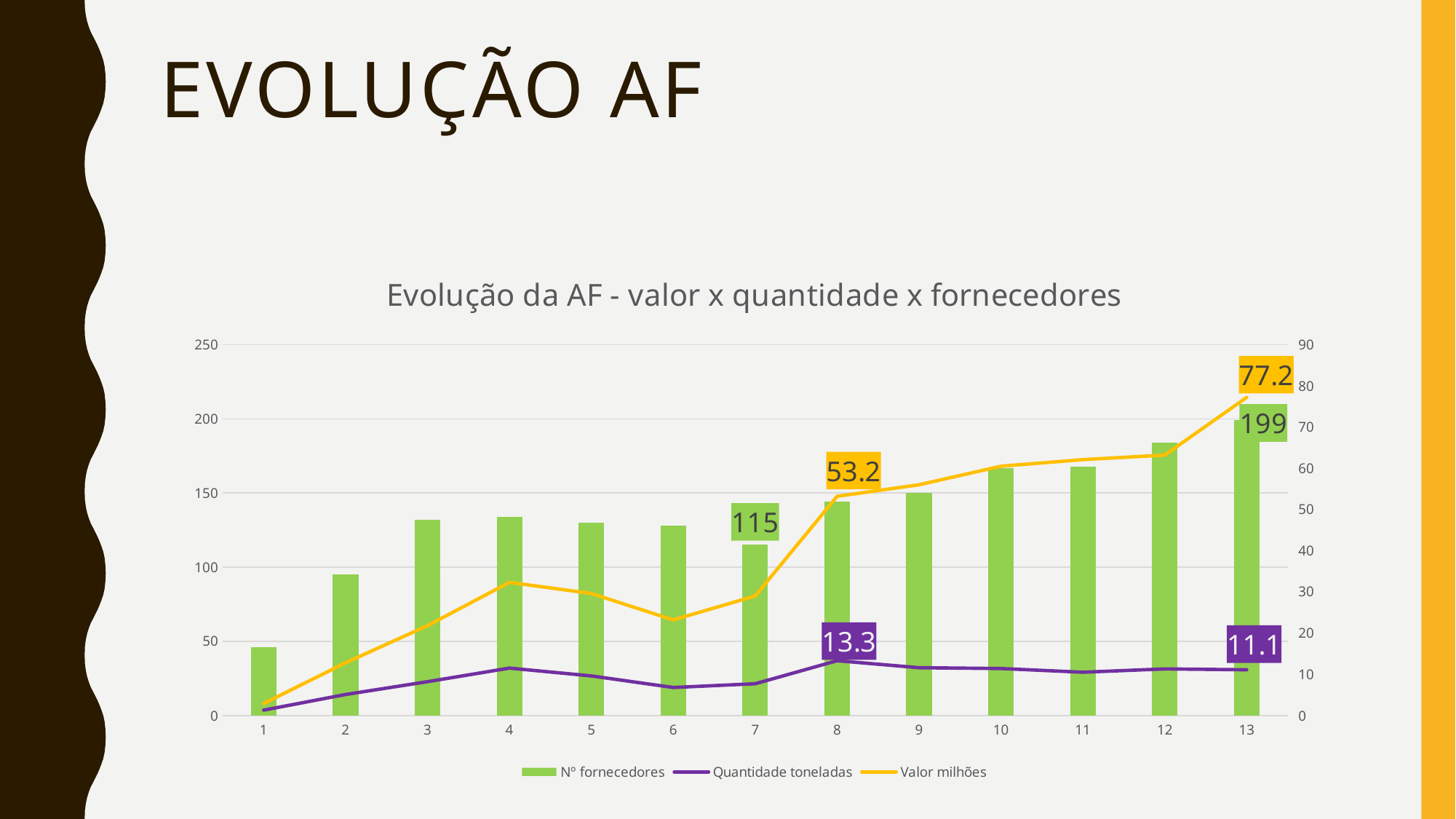
Does the Valor milhões line generally rise or fall from category 1 to category 13? Rise What is the value of Valor milhões at category 8? 53.2 What is the value of Nº fornecedores at category 13? 199 How many categories are shown on the x axis? 13 What is the difference between Nº fornecedores at category 13 and at category 7? 84 What is the value of Quantidade toneladas at category 13? 11.1 What is the value of Nº fornecedores at category 7? 115 Is the Nº fornecedores value for category 2 greater or less than 100? less Which category has the lowest Nº fornecedores bar? 1 How many series does the legend list? 3 Which is larger for Quantidade toneladas: category 8 or category 13? Category 8 What is the difference between Valor milhões at category 13 and at category 8? 24.0